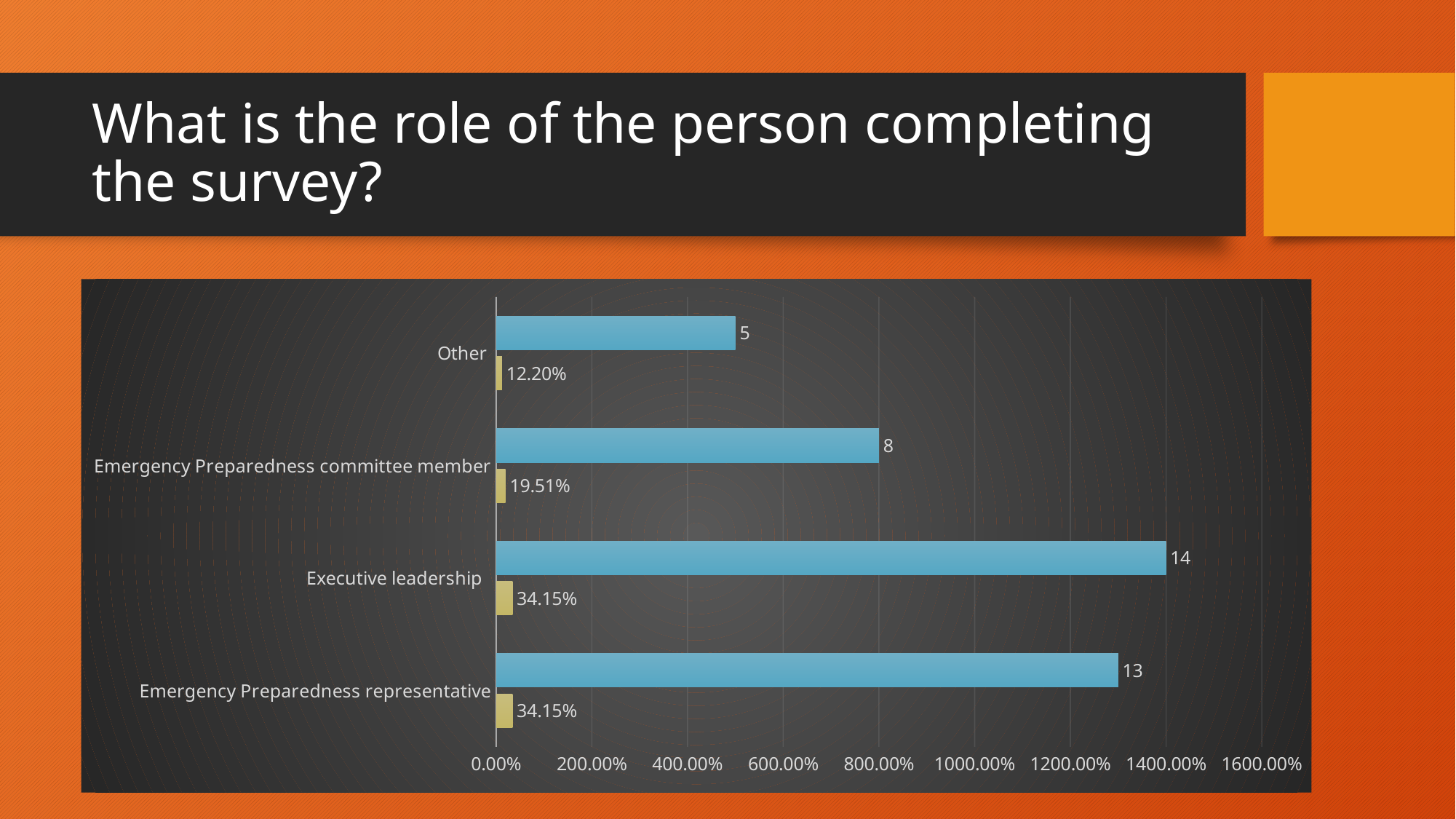
What is the count value (blue bar) for Executive leadership? 14 What is the count value (blue bar) for Other? 5 Which category has the highest count (blue bar)? Executive leadership What kind of chart is shown on the slide? bar chart What is the percentage value (yellow bar) for Emergency Preparedness representative? 34.15% What is the percentage value (yellow bar) for Emergency Preparedness committee member? 19.51% Which category has the lowest count (blue bar)? Other What is the percentage value (yellow bar) for Other? 12.20% How many categories are shown on the chart? 4 Which has a larger count (blue bar): Emergency Preparedness representative or Other? Emergency Preparedness representative What is the difference between the count for Executive leadership and the count for Emergency Preparedness committee member? 6 What is the title of the slide containing the chart? What is the role of the person completing the survey?